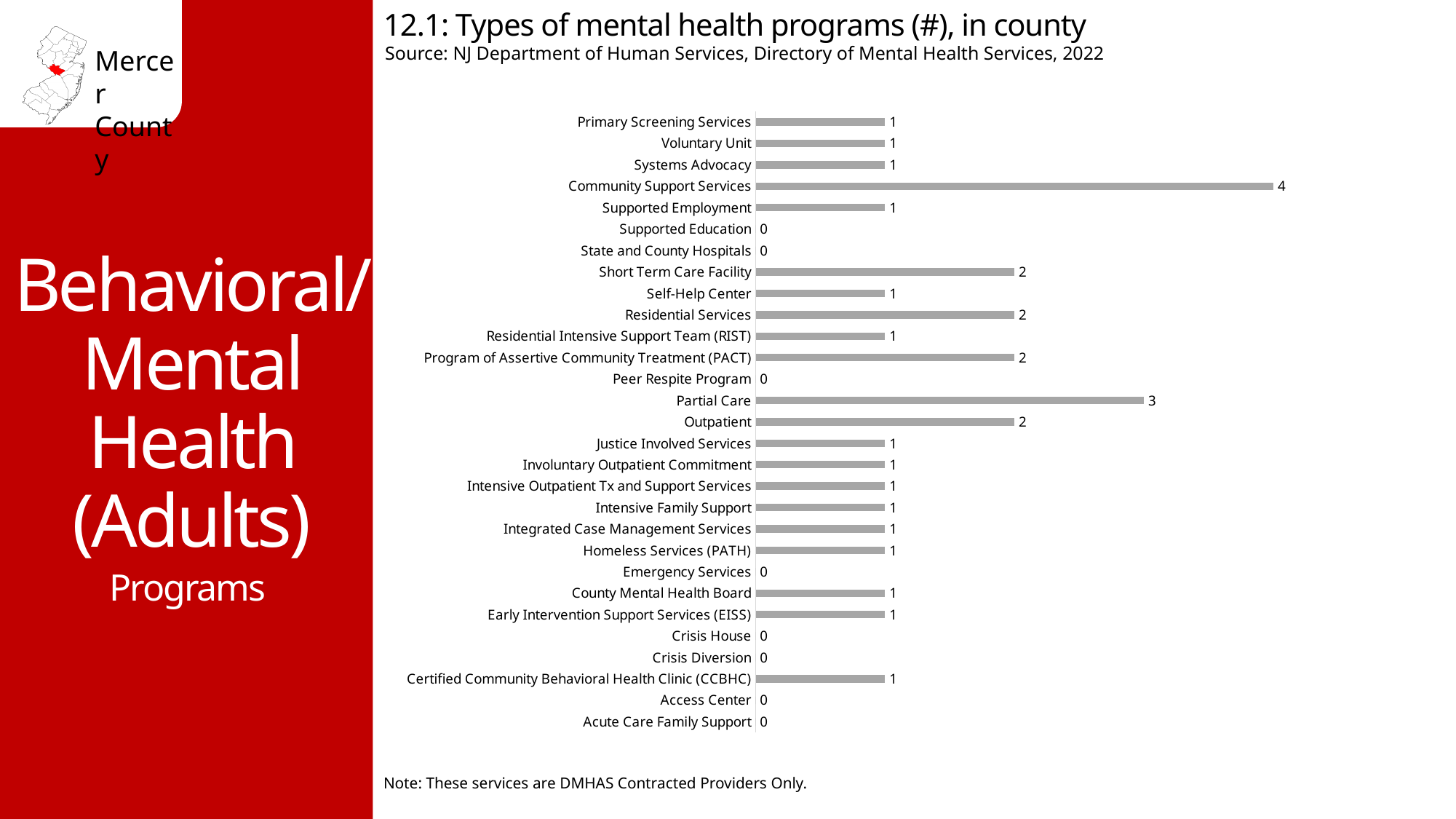
Which has a larger value, Residential Services or Self-Help Center? Residential Services What is the value for Peer Respite Program? 0 Which type of mental health program has the highest count? Community Support Services What is the value shown for Partial Care? 3 What is the difference between the values for Partial Care and Outpatient? 1 What is the source cited for the chart? NJ Department of Human Services, Directory of Mental Health Services, 2022 How many program types are listed on the chart? 29 What kind of chart is used to show the types of mental health programs? Bar chart What is the difference between the values for Community Support Services and Partial Care? 1 How many Short Term Care Facility programs are shown? 2 Which has a larger value, Partial Care or Program of Assertive Community Treatment (PACT)? Partial Care What is the number of Community Support Services programs in the county? 4